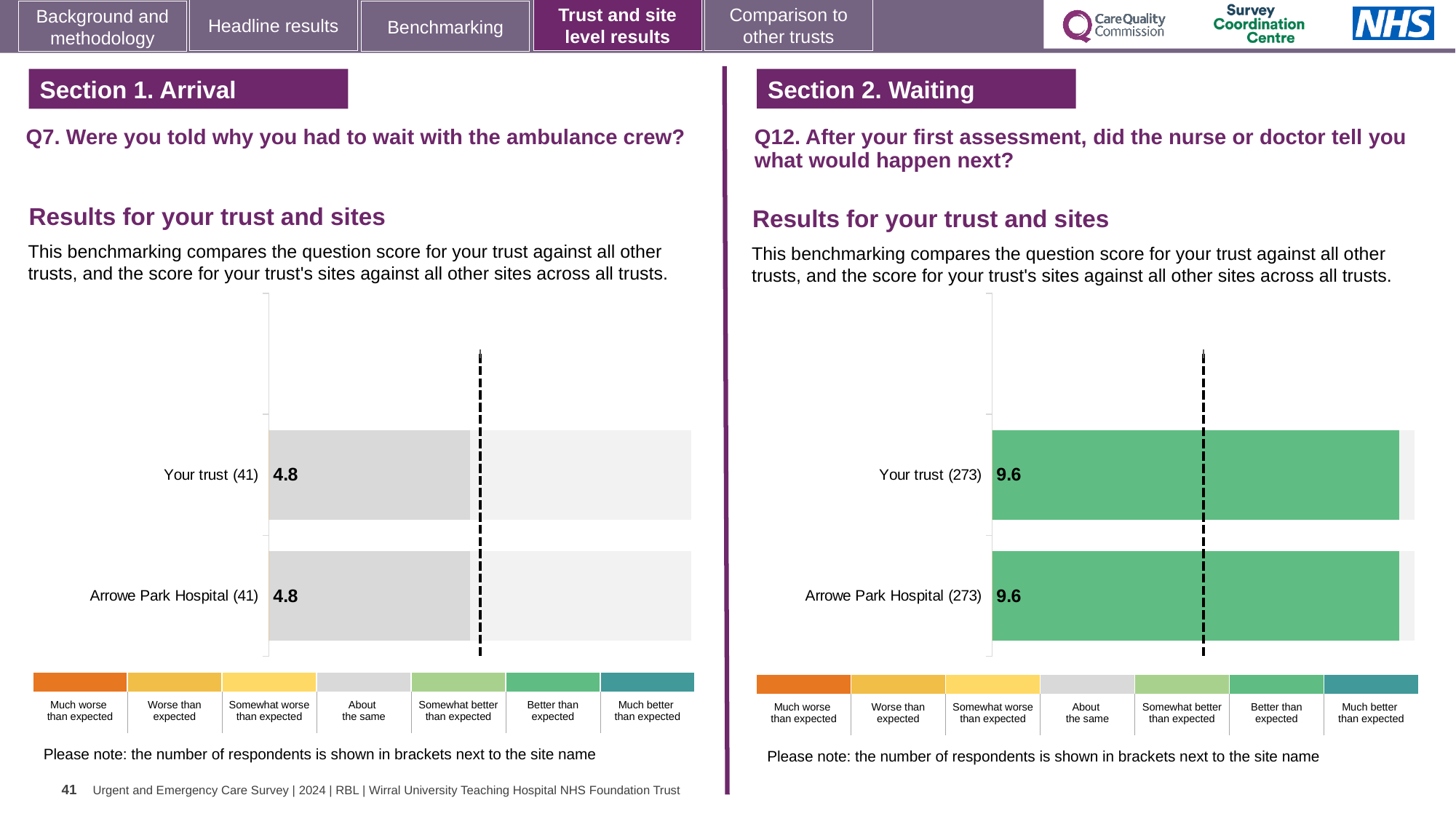
How many bars are plotted in the Q7 chart on the left? 2 What kind of chart is the Q12 chart on the right? Bar chart In the Q7 chart on the left, what is the score for Your trust? 4.8 According to the colour key, which benchmark category do the green bars in the Q12 chart on the right represent? Better than expected How many bars are plotted in the Q12 chart on the right? 2 In the Q7 chart on the left, what is the difference between the Your trust score and the Arrowe Park Hospital score? 0 In the Q12 chart on the right, what is the score for Your trust? 9.6 In the Q7 chart on the left, how many respondents are shown in brackets for Your trust? 41 In the Q12 chart on the right, how many respondents are shown in brackets for Arrowe Park Hospital? 273 In the Q7 chart on the left, what is the score for Arrowe Park Hospital? 4.8 In the Q12 chart on the right, what is the score for Arrowe Park Hospital? 9.6 In the Q12 chart on the right, what is the difference between the Your trust score and the Arrowe Park Hospital score? 0